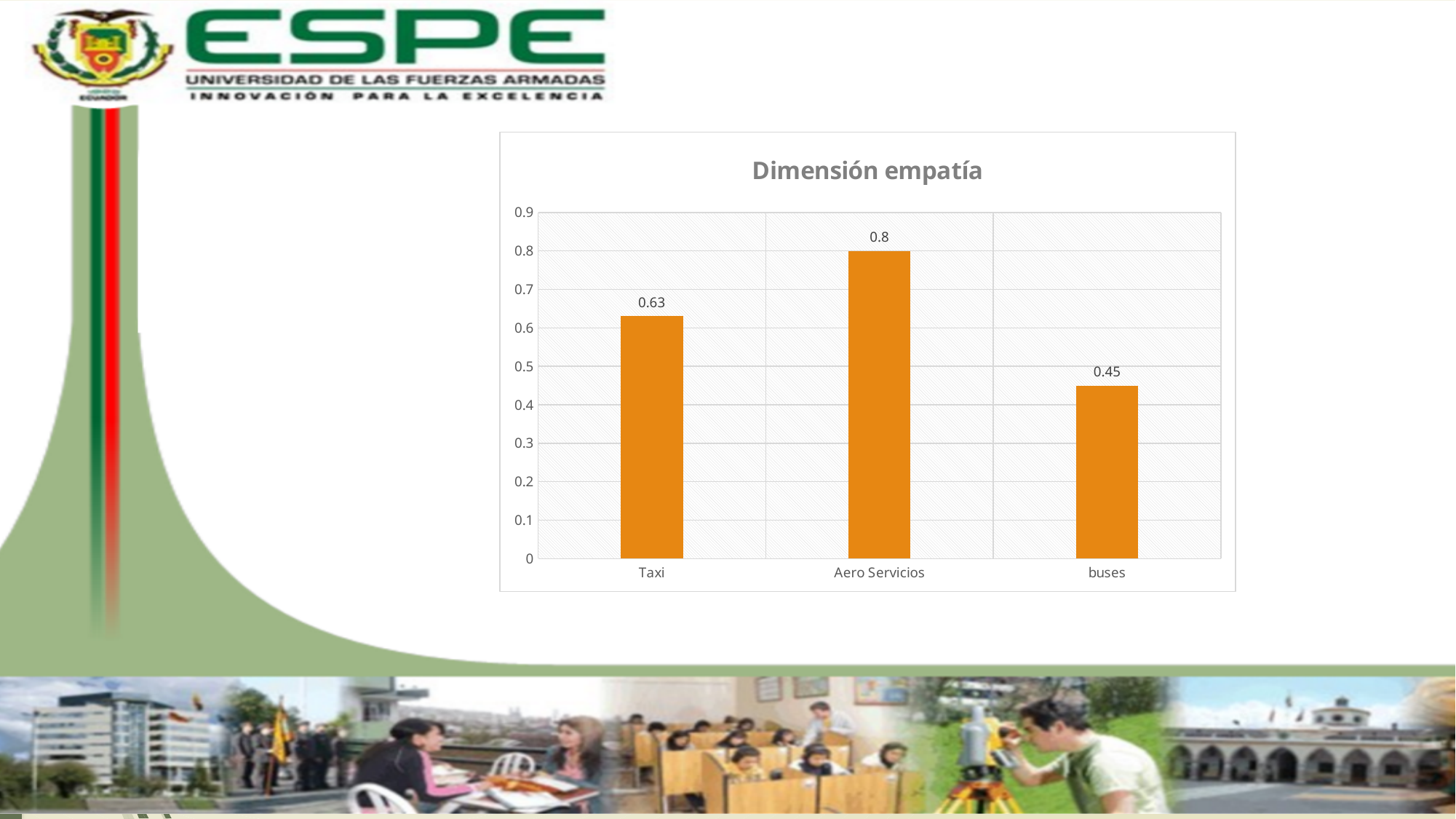
Which category has the highest value? Aero Servicios What is the value for Aero Servicios? 0.8 What is the title of the chart? Dimensión empatía How many categories are shown on the x axis? 3 Which is larger, the value for Taxi or the value for buses? Taxi Is the value for buses greater or less than 0.5? less What is the value for Taxi? 0.63 What is the difference between the values for Taxi and buses? 0.18 What kind of chart is shown? bar chart What is the difference between the values for Aero Servicios and Taxi? 0.17 Which category has the lowest value? buses What is the value for buses? 0.45